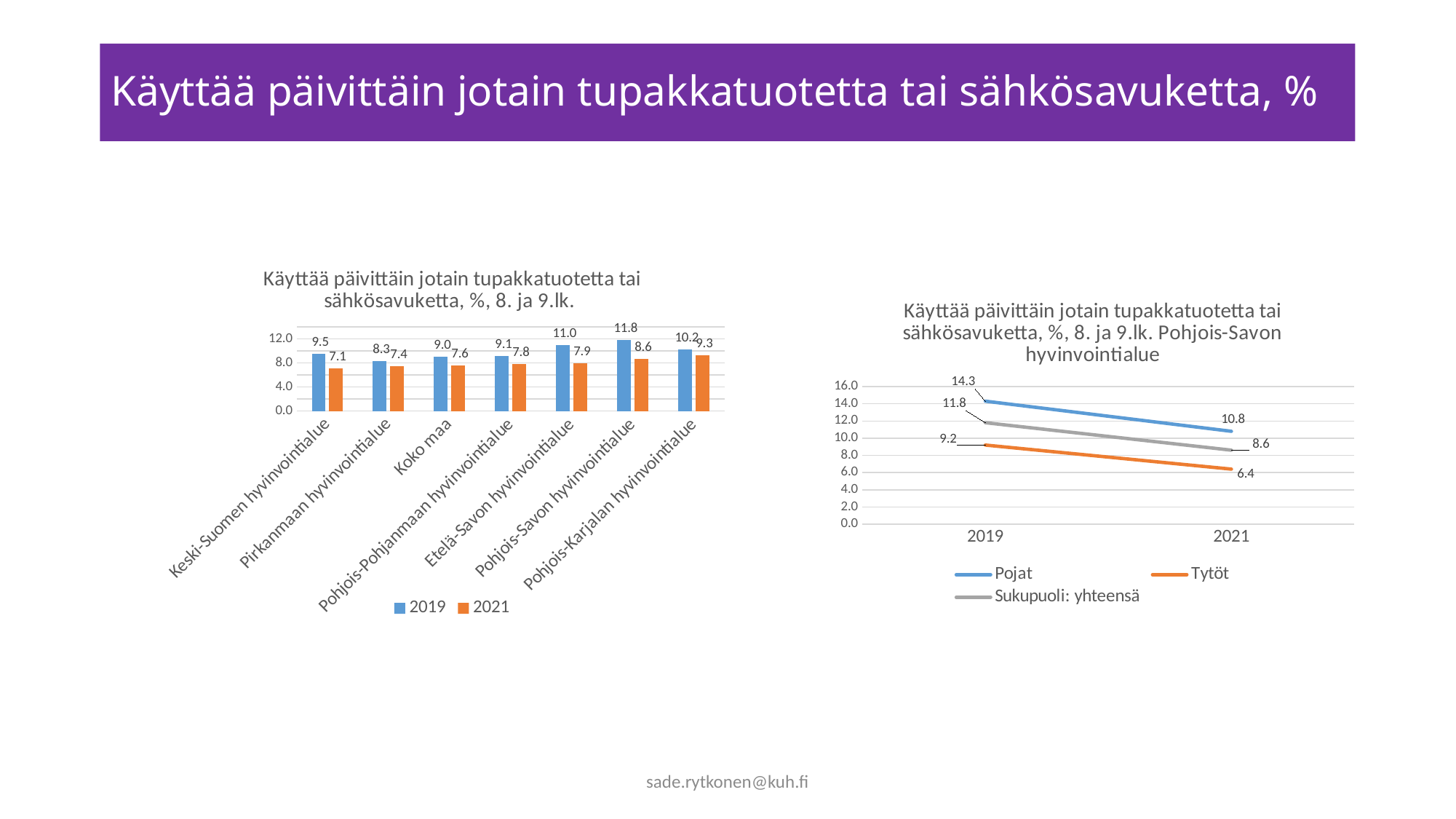
In the left chart, how many categories are shown on the x axis? 7 In the right chart, what is the value for Pojat in 2021? 10.8 What kind of chart is the left chart? Bar chart In the left chart, what is the 2019 value for Pohjois-Savon hyvinvointialue? 11.8 In the left chart, which category has the lowest 2021 value? Keski-Suomen hyvinvointialue In the right chart, what is the value for Tytöt in 2019? 9.2 In the right chart, how many series does the legend list? 3 In the left chart, which category has the highest 2019 value? Pohjois-Savon hyvinvointialue In the right chart, does the value for Sukupuoli: yhteensä rise or fall from 2019 to 2021? Fall In the right chart, what is the difference between the Pojat and Tytöt values in 2021? 4.4 In the left chart, what is the 2021 value for Koko maa? 7.6 In the left chart, what is the difference between the 2019 and 2021 values for Etelä-Savon hyvinvointialue? 3.1